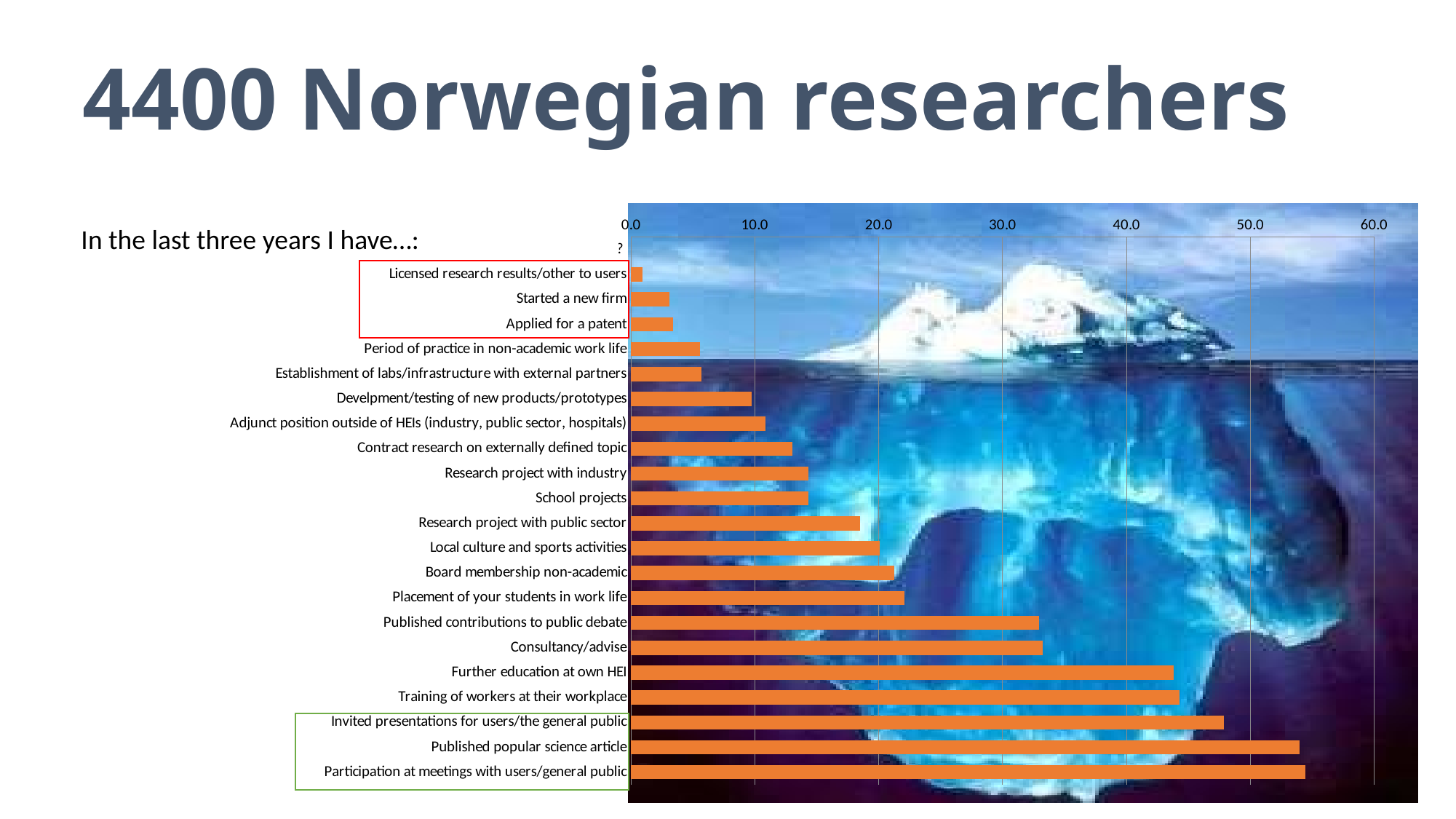
What is the highest value shown on the chart's horizontal axis? 60.0 Is the value for Research project with public sector greater or less than 20.0? less Which has the larger value: Further education at own HEI or Consultancy/advise? Further education at own HEI Is the value for Started a new firm greater or less than 10.0? less Which has the larger value: Training of workers at their workplace or Placement of your students in work life? Training of workers at their workplace Which category has the lowest value in the chart? Licensed research results/other to users Is the value for Invited presentations for users/the general public greater or less than 50.0? less Do the bar values increase or decrease going down the list of categories from top to bottom? increase What kind of chart is shown on the slide? bar chart